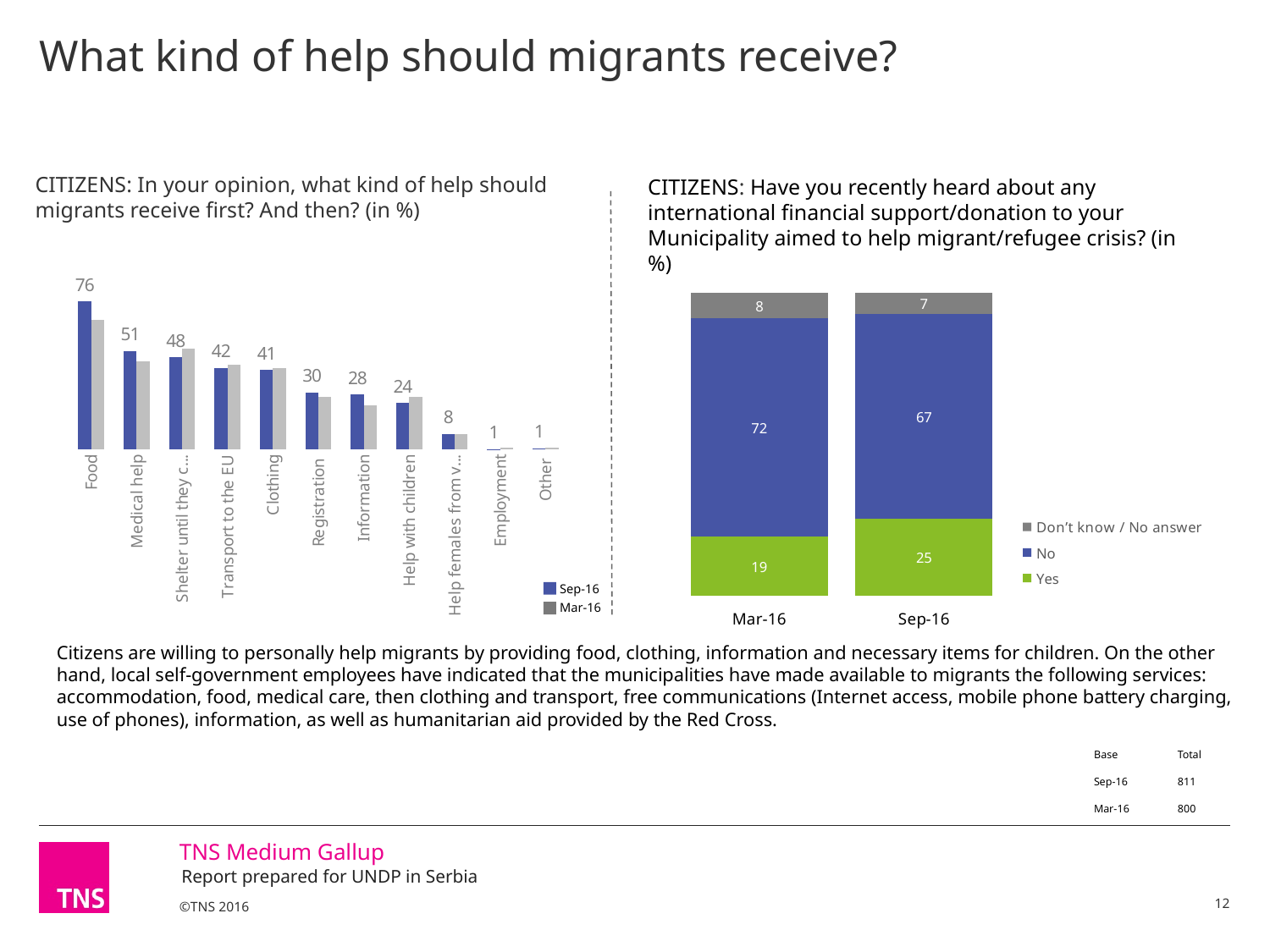
In the chart 'What kind of help should migrants receive first?', what is the Sep-16 value for Food? 76 In the chart 'What kind of help should migrants receive first?', which category has the highest value? Food In the chart 'What kind of help should migrants receive first?', what is the difference between the Sep-16 values for Food and Medical help? 25 In the chart about international financial support to the Municipality, what is the difference between the 'No' values for Mar-16 and Sep-16? 5 In the chart about international financial support to the Municipality, which period has the larger 'Yes' value, Mar-16 or Sep-16? Sep-16 In the chart 'What kind of help should migrants receive first?', do the Sep-16 values rise or fall from left to right along the x axis? fall In the chart about international financial support to the Municipality, what is the 'Yes' value for Sep-16? 25 In the chart about international financial support to the Municipality, how many series does the legend list? 3 In the chart 'What kind of help should migrants receive first?', how many categories are shown on the x axis? 11 In the chart 'What kind of help should migrants receive first?', what is the Sep-16 value for Registration? 30 In the chart 'What kind of help should migrants receive first?', how many series does the legend list? 2 In the chart about international financial support to the Municipality, what is the 'No' value for Mar-16? 72